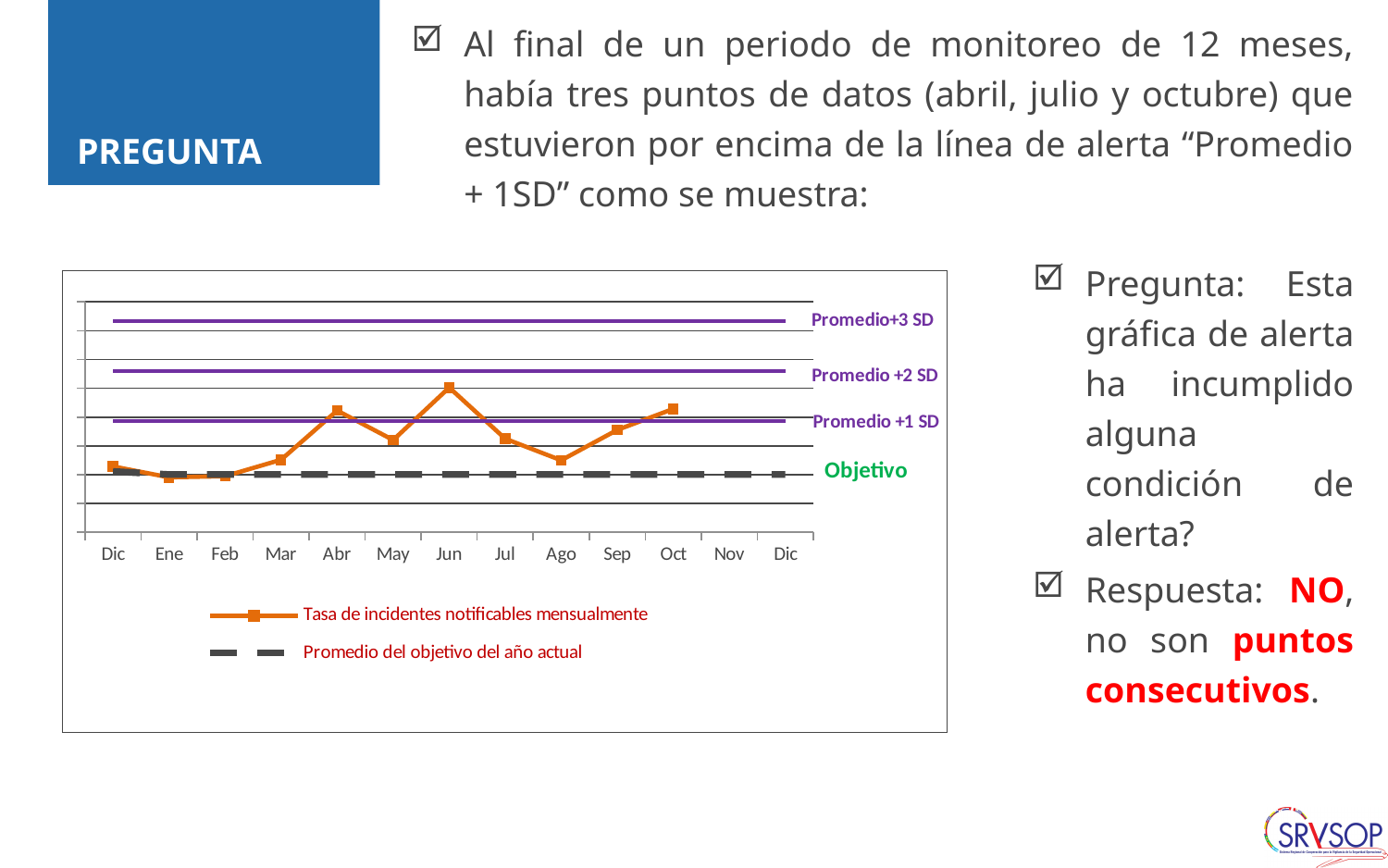
How many series does the chart legend list? 2 Which month has the higher value for 'Tasa de incidentes notificables mensualmente', May or Jun? Jun Which month has the higher value for 'Tasa de incidentes notificables mensualmente', Ago or Oct? Oct What kind of chart is shown on the slide? Line chart What is the label of the green-labelled dashed horizontal line on the chart? Objetivo Which month has the higher value for 'Tasa de incidentes notificables mensualmente', Abr or Jun? Jun How many category labels are shown along the x axis of the chart? 13 What is the label of the topmost purple horizontal line on the chart? Promedio+3 SD Does the 'Tasa de incidentes notificables mensualmente' line rise or fall from Feb to Abr? Rise Does the 'Tasa de incidentes notificables mensualmente' line rise or fall from Jun to Ago? Fall In which month does the 'Tasa de incidentes notificables mensualmente' line reach its highest point? Jun Does the 'Tasa de incidentes notificables mensualmente' line rise or fall from Ago to Oct? Rise